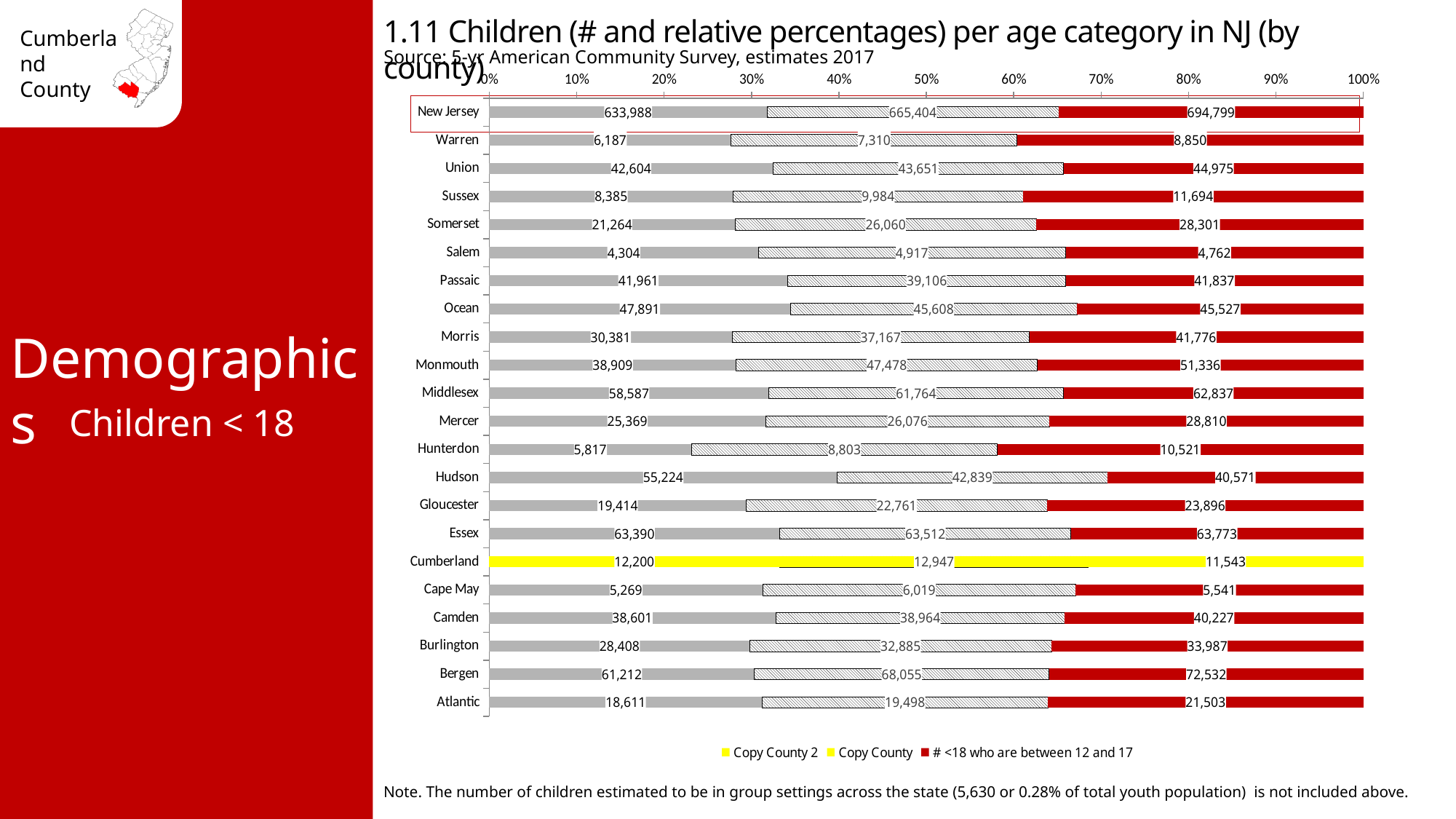
What is the total of the three segments for Cumberland? 36,690 Among the counties (excluding New Jersey), which has the smallest value for the red segment (# <18 who are between 12 and 17)? Salem What is the value of the third (rightmost) segment for Cumberland? 11,543 How many rows (New Jersey plus counties) are plotted in the chart? 22 What is the value of the first (leftmost) segment for Hudson? 55,224 What is the value of the first (leftmost) segment for Cumberland? 12,200 How many series does the chart legend list? 3 Is the share of Hunterdon's first (leftmost) segment greater or less than 30%? less What type of chart is shown on the slide? Stacked horizontal bar chart Which has the larger value for the first (leftmost) segment, Hudson or Essex? Essex What is the value of the red segment (# <18 who are between 12 and 17) for New Jersey? 694,799 What is the difference between Cumberland's middle segment (12,947) and its rightmost segment (11,543)? 1,404